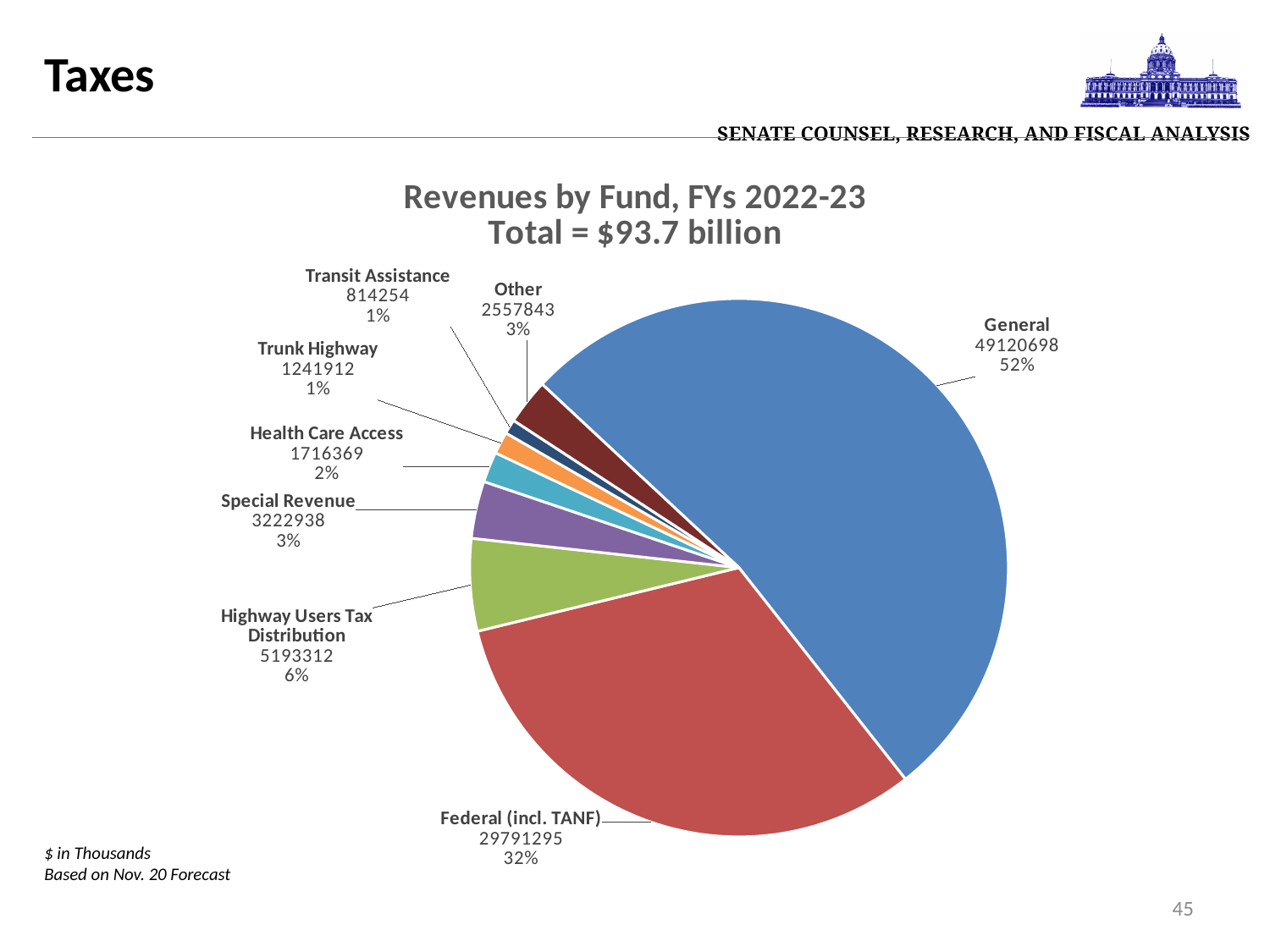
What is the title of the chart? Revenues by Fund, FYs 2022-23 Total = $93.7 billion What percentage share is shown for Health Care Access? 2% Which is larger, Special Revenue or Health Care Access? Special Revenue How many slices does the pie chart have? 8 What is the difference between the General value and the Federal (incl. TANF) value? 19329403 Which fund has the largest slice of the pie? General What is the value shown for Other? 2557843 What is the value shown for Highway Users Tax Distribution? 5193312 What kind of chart is shown on the slide? Pie chart Which fund has the smallest slice of the pie? Transit Assistance What share of the pie does Federal (incl. TANF) represent? 32% What is the value shown for the General fund? 49120698